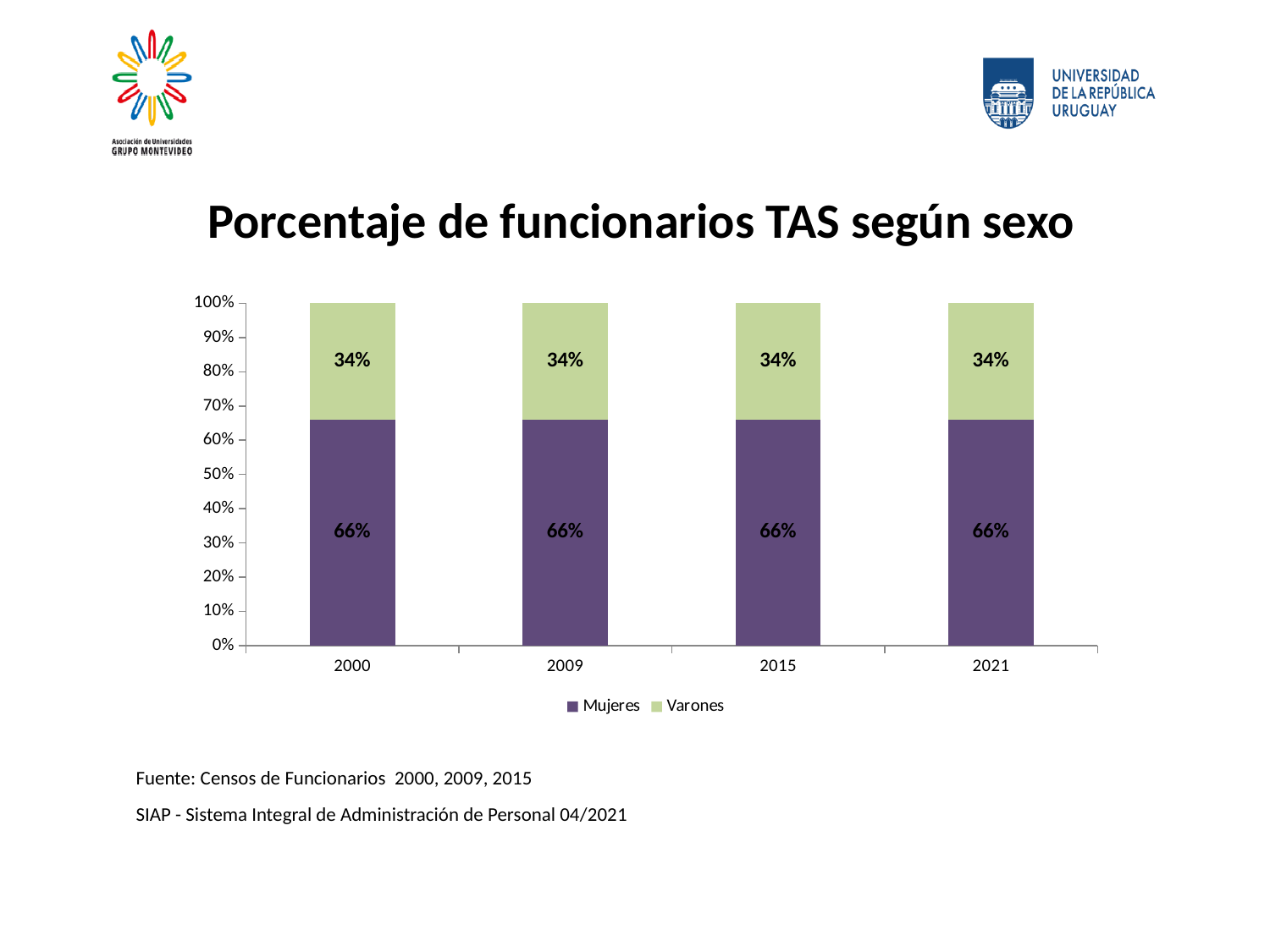
Does the value for Mujeres rise, fall or stay the same from 2000 to 2021? Stays the same Which series is larger in 2021, Mujeres or Varones? Mujeres What is the value for Mujeres in 2015? 66% How many series does the legend list? 2 What is the value for Varones in 2009? 34% What is the total of the stacked bar for 2015? 100% What is the value for Varones in 2021? 34% What is the difference between Mujeres and Varones in 2009? 32% How many years are shown on the x axis? 4 What is the value for Mujeres in 2000? 66% What kind of chart is shown? Stacked bar chart What is the title of the chart? Porcentaje de funcionarios TAS según sexo